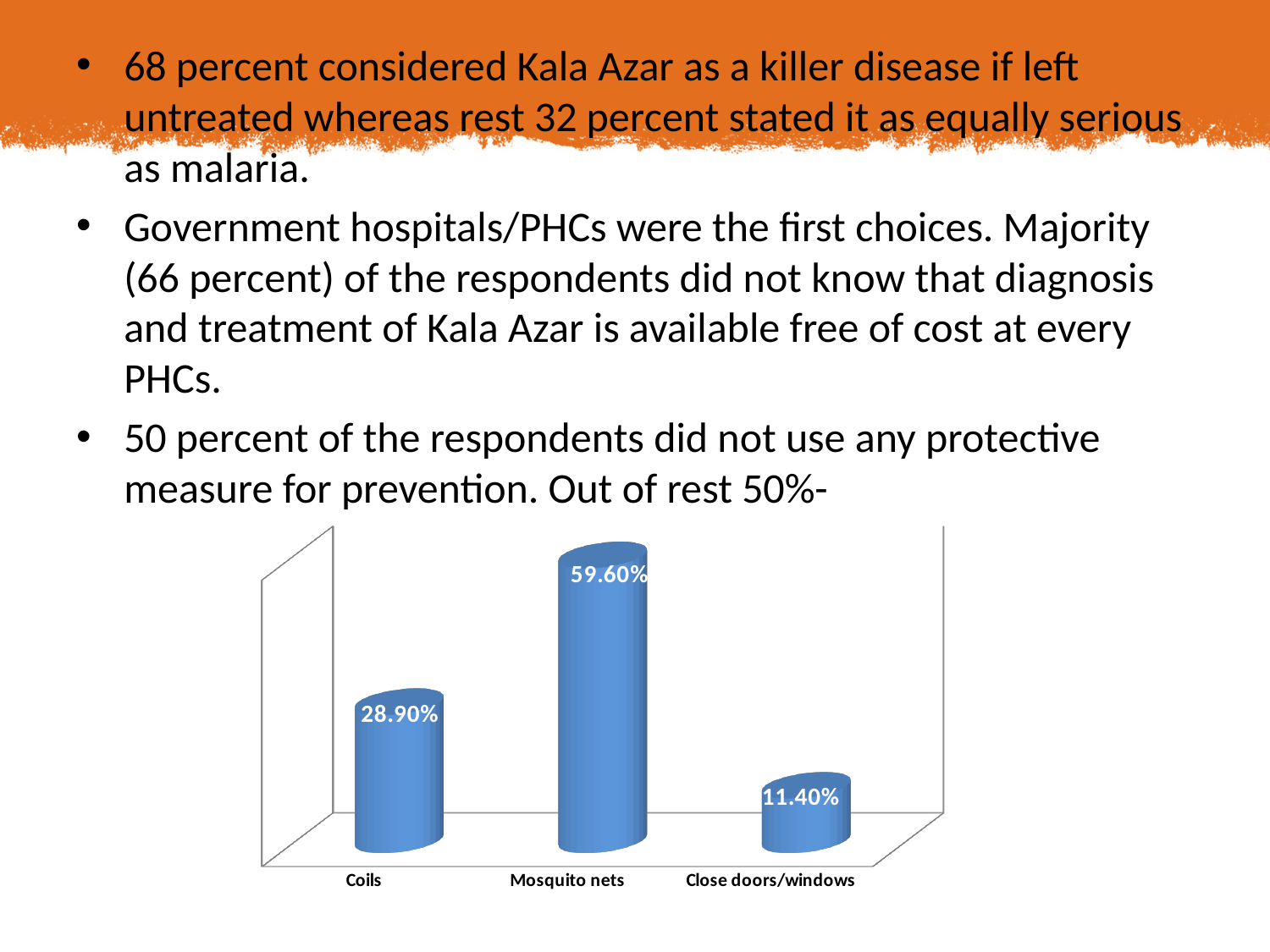
What kind of chart is shown on the slide? Bar chart Which is larger, the value for Coils or the value for Close doors/windows? Coils What is the difference between the values for Coils and Close doors/windows? 17.50% What is the value for Coils? 28.90% What is the value for Close doors/windows? 11.40% What is the value for Mosquito nets? 59.60% What is the total of the three values shown in the chart? 99.90% What is the difference between the values for Mosquito nets and Coils? 30.70% Which category has the lowest value? Close doors/windows What colour are the bars in the chart? Blue How many categories are shown in the chart? 3 Which category has the highest value? Mosquito nets